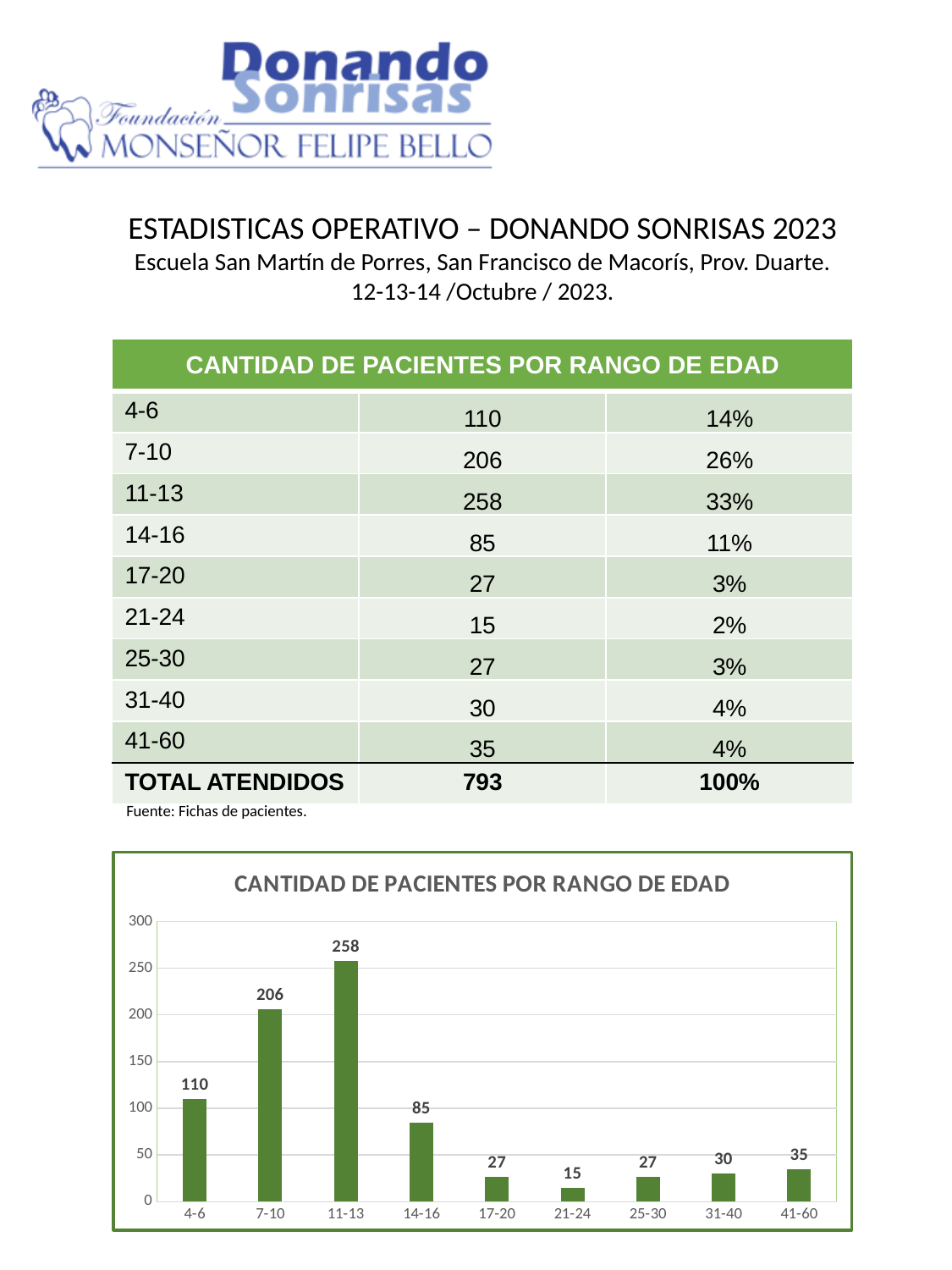
What is the value for the 41-60 age range in the chart? 35 What kind of chart is shown on the slide? bar chart What is the difference between the values for 4-6 and 14-16 in the chart? 25 Which is larger in the chart, the value for 31-40 or the value for 41-60? 41-60 Is the value for 7-10 in the chart greater or less than 200? greater What is the value for the 14-16 age range in the chart? 85 Which age range has the highest number of patients in the chart? 11-13 What is the value for the 11-13 age range in the chart? 258 What is the title of the chart? CANTIDAD DE PACIENTES POR RANGO DE EDAD What is the difference between the values for 11-13 and 7-10 in the chart? 52 Which age range has the lowest number of patients in the chart? 21-24 How many age ranges are shown on the x axis of the chart? 9